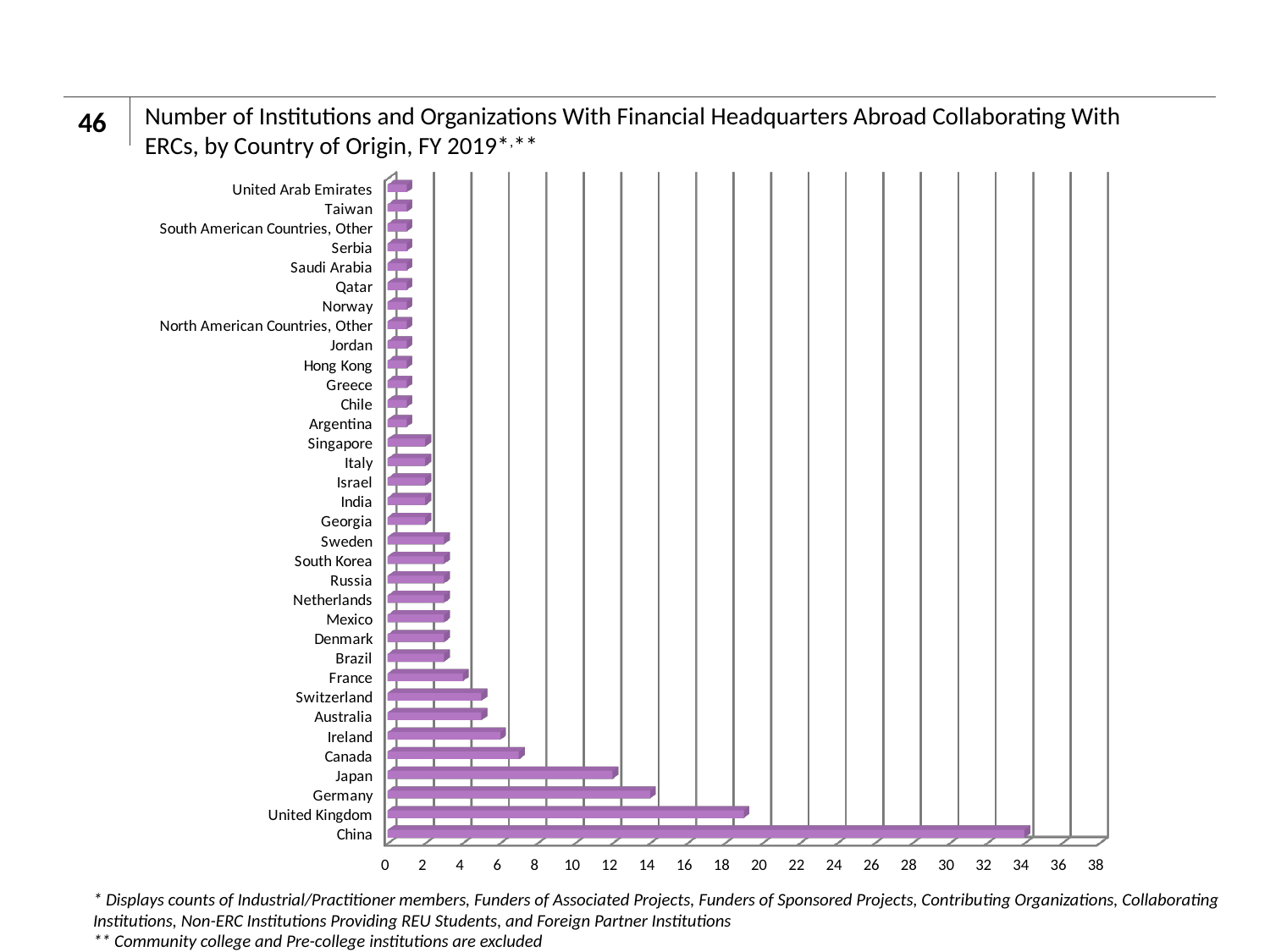
Which has a larger value, Japan or Canada? Japan Is the value for United Kingdom greater or less than 20? less Is the value for Canada greater or less than 10? less How many countries or regions are listed on the chart? 34 What kind of chart is shown on the slide? bar chart Which country has the highest number of institutions and organizations collaborating with ERCs? China Is the value for Germany greater or less than 12? greater What fiscal year does the chart title refer to? FY 2019 Which has a larger value, China or United Kingdom? China Which has a larger value, Germany or Japan? Germany